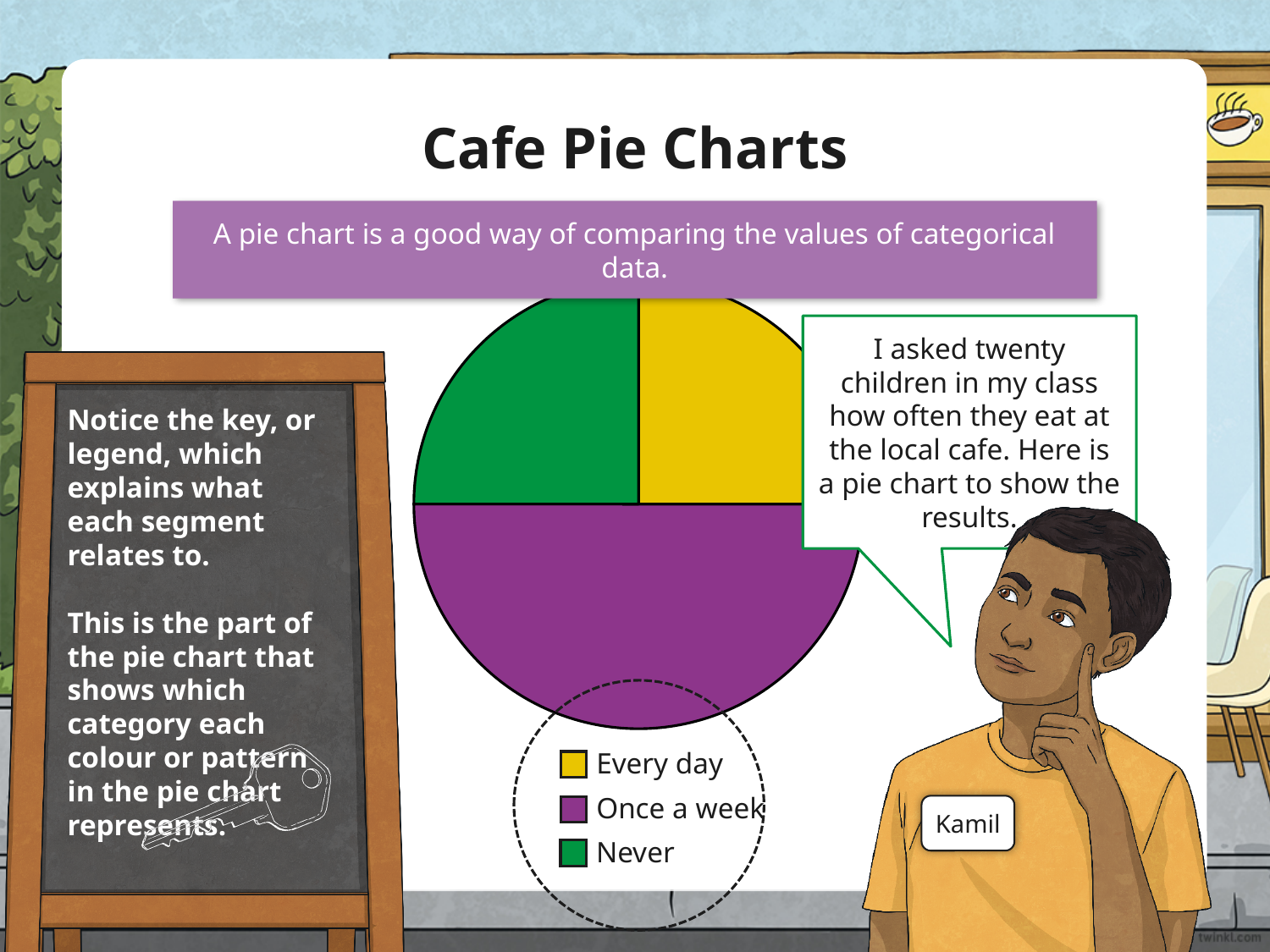
Which slice is larger, Once a week or Every day? Once a week Which colour represents the Never category in the pie chart? green What kind of chart is shown on the slide? pie chart Which category is shown in yellow in the pie chart? Every day How many entries does the legend of the pie chart list? 3 Which category has the largest slice of the pie chart? Once a week How many categories does the pie chart show? 3 Which slice is larger, Never or Once a week? Once a week